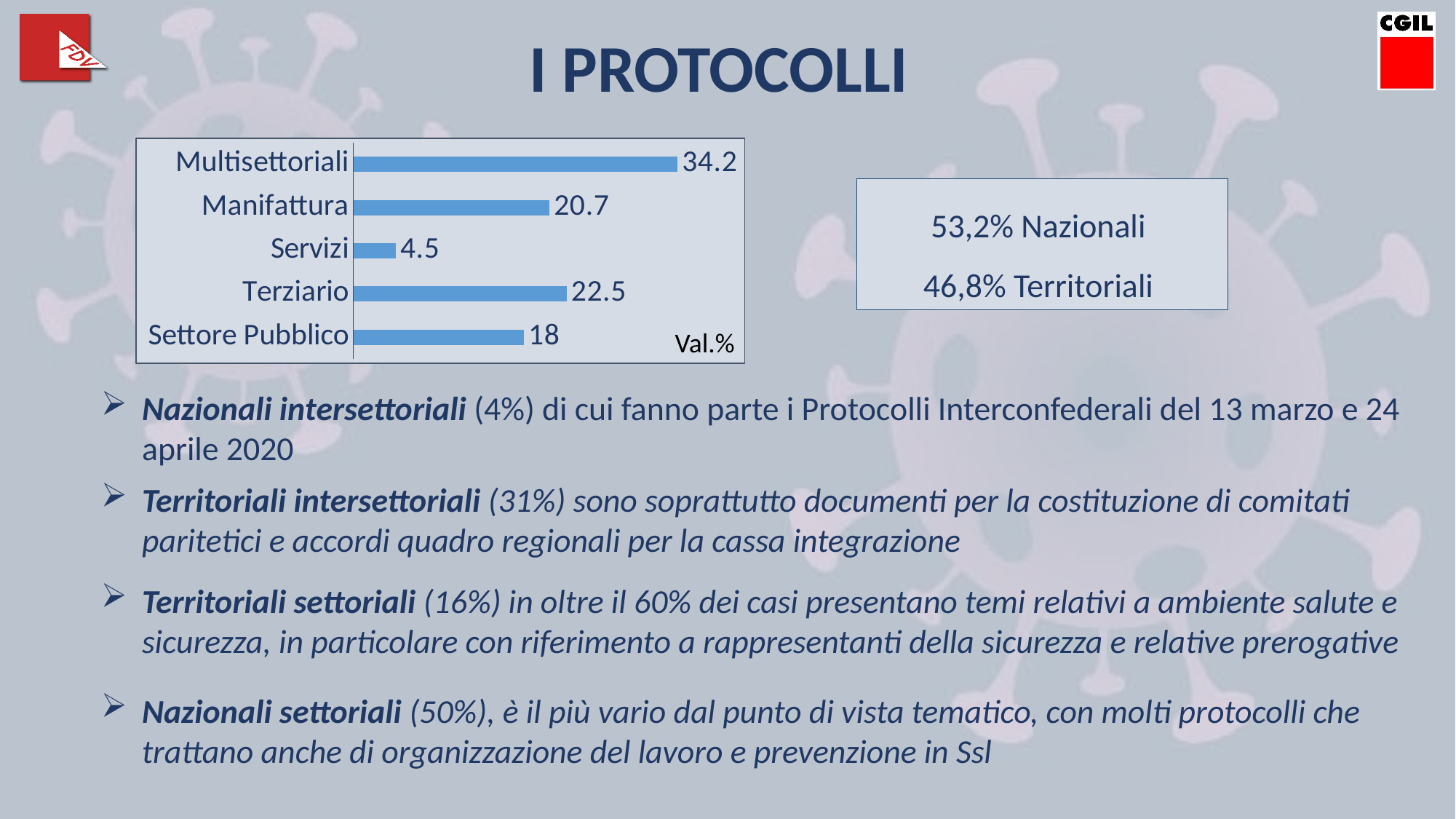
What is the value for Manifattura? 20.7 Which category has the highest value? Multisettoriali What unit label is printed inside the chart area? Val.% What is the difference between the values for Terziario and Manifattura? 1.8 How many categories are shown in the chart? 5 Which category has the lowest value? Servizi What is the difference between the values for Multisettoriali and Terziario? 11.7 What kind of chart is shown on the slide? Bar chart Which is larger, the value for Terziario or the value for Settore Pubblico? Terziario What is the value for Servizi? 4.5 What is the value for Settore Pubblico? 18 What is the value for Multisettoriali? 34.2